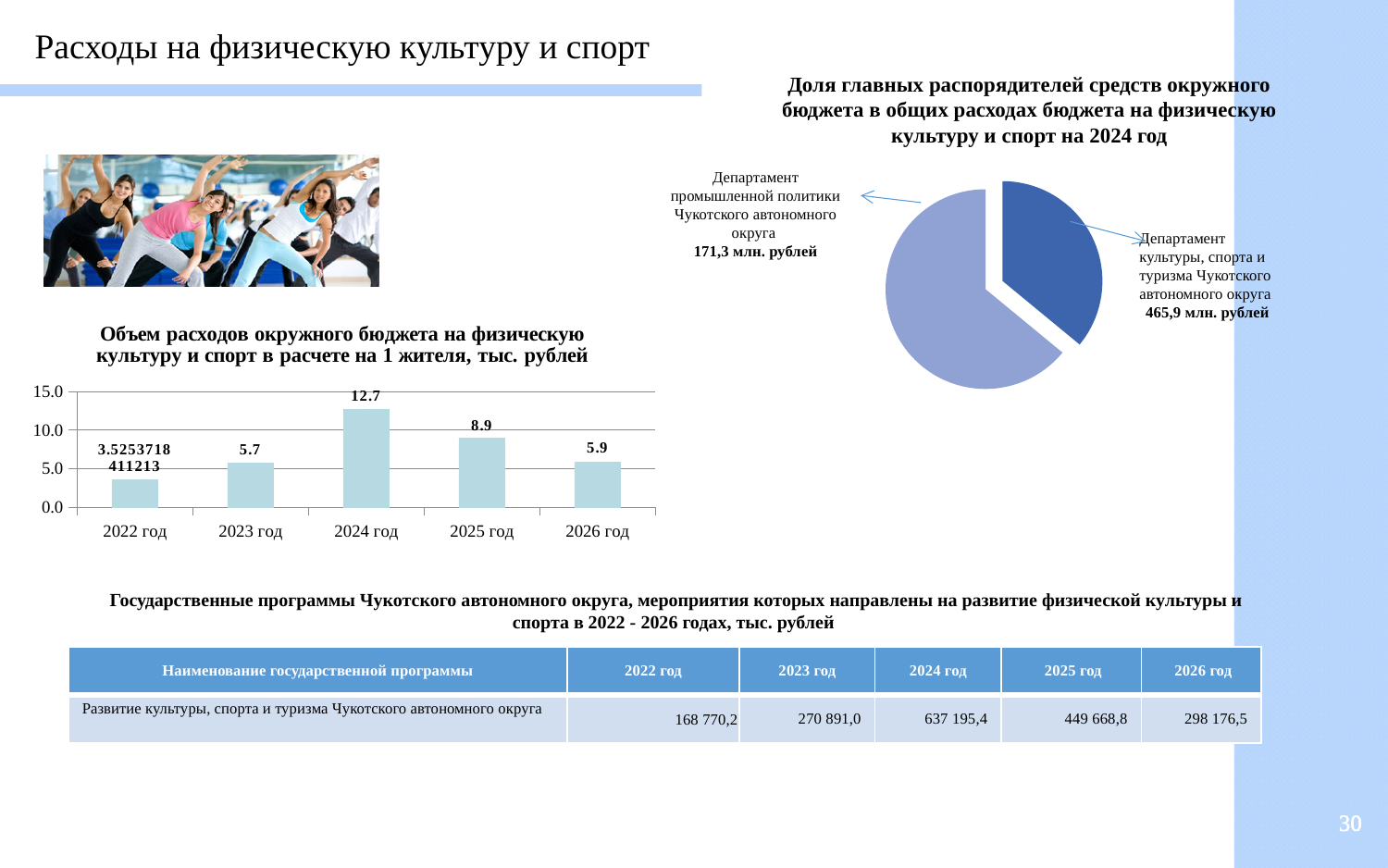
In the bar chart 'Объем расходов окружного бюджета на физическую культуру и спорт в расчете на 1 жителя', which is larger, the value for 2023 год or 2026 год? 2026 год In the bar chart 'Объем расходов окружного бюджета на физическую культуру и спорт в расчете на 1 жителя', which year has the highest value? 2024 год In the bar chart 'Объем расходов окружного бюджета на физическую культуру и спорт в расчете на 1 жителя', what is the value for 2023 год? 5.7 In the bar chart 'Объем расходов окружного бюджета на физическую культуру и спорт в расчете на 1 жителя', which year has the lowest value? 2022 год In the bar chart 'Объем расходов окружного бюджета на физическую культуру и спорт в расчете на 1 жителя', what is the value for 2024 год? 12.7 How many years are shown in the bar chart 'Объем расходов окружного бюджета на физическую культуру и спорт в расчете на 1 жителя'? 5 What type of chart is 'Доля главных распорядителей средств окружного бюджета в общих расходах бюджета на физическую культуру и спорт на 2024 год'? pie chart In the bar chart 'Объем расходов окружного бюджета на физическую культуру и спорт в расчете на 1 жителя', what is the value for 2025 год? 8.9 In the bar chart 'Объем расходов окружного бюджета на физическую культуру и спорт в расчете на 1 жителя', what is the difference between the values for 2024 год and 2025 год? 3.8 In the bar chart 'Объем расходов окружного бюджета на физическую культуру и спорт в расчете на 1 жителя', is the value for 2022 год greater or less than 5.0? less In the pie chart 'Доля главных распорядителей средств окружного бюджета в общих расходах бюджета на физическую культуру и спорт на 2024 год', what is the value for Департамент культуры, спорта и туризма Чукотского автономного округа? 465,9 млн. рублей